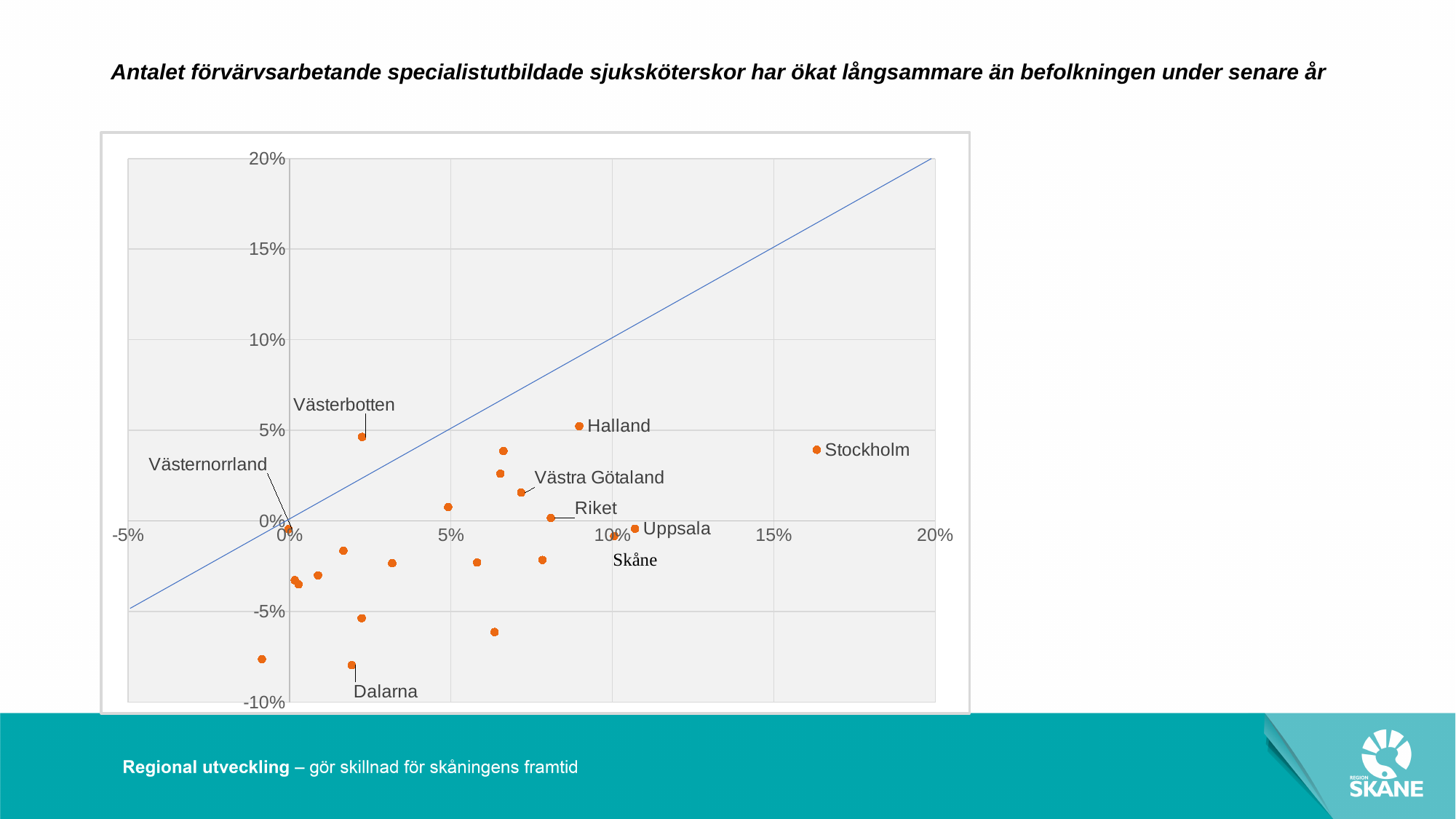
Which has the larger horizontal-axis value, Uppsala or Riket? Uppsala What kind of chart is shown on the slide? scatter chart Which labelled region has the lowest value on the vertical axis? Dalarna Is the vertical-axis value for Västerbotten greater or less than 0%? greater Is the vertical-axis value for Västra Götaland greater or less than 5%? less What colour are the data points on the chart? orange Which labelled region has the highest value on the horizontal axis? Stockholm Which has the larger vertical-axis value, Halland or Stockholm? Halland Is the vertical-axis value for Dalarna greater or less than -5%? less Which labelled region has the highest value on the vertical axis? Halland How many data points on the chart have a region name label? 9